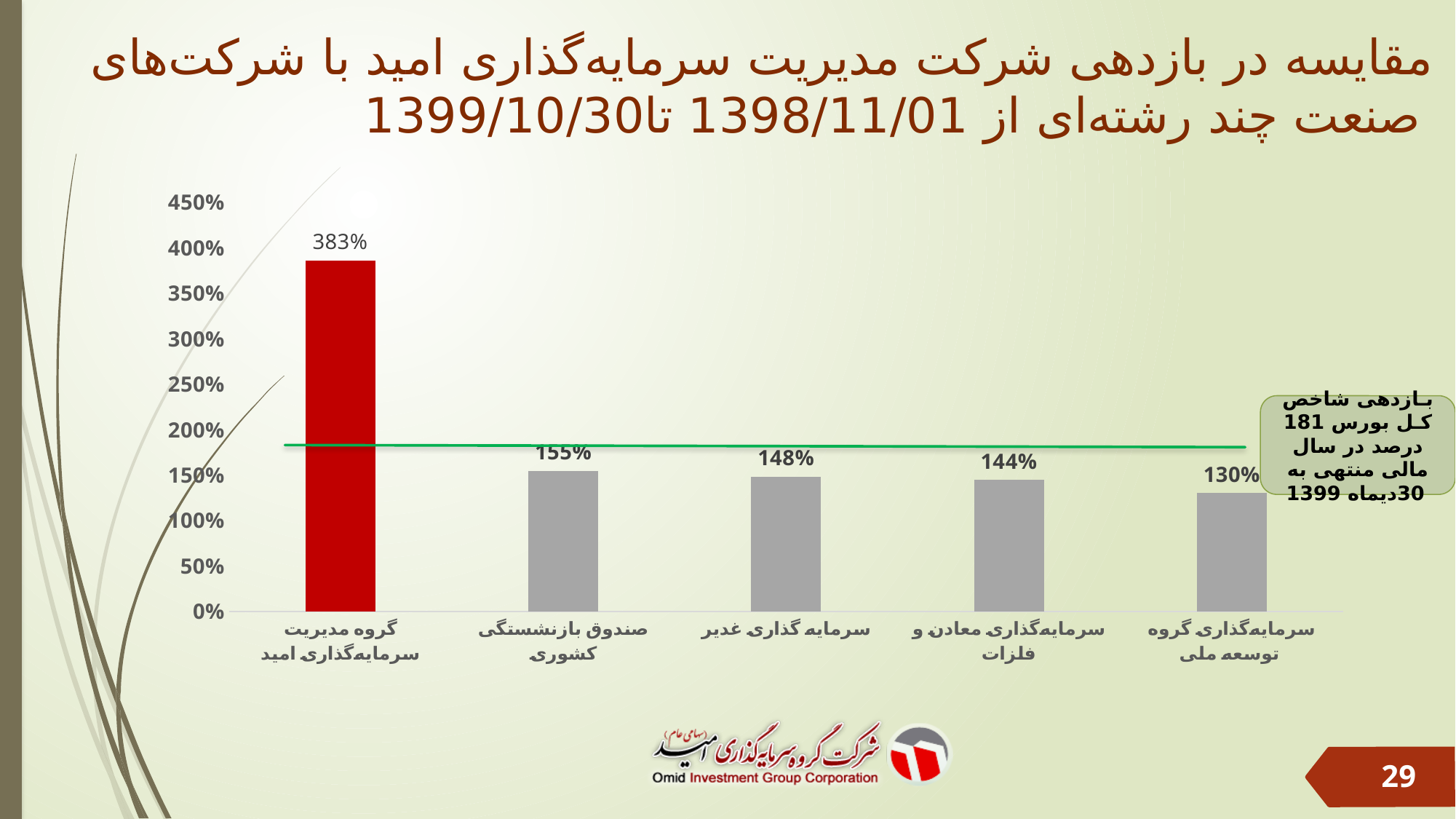
What is the value shown for گروه مدیریت سرمایه‌گذاری امید? 383% What is the value shown for صندوق بازنشستگی کشوری? 155% Which is larger, the value for سرمایه گذاری غدیر or the value for سرمایه‌گذاری گروه توسعه ملی? سرمایه گذاری غدیر What is the value shown for سرمایه‌گذاری معادن و فلزات? 144% What kind of chart is shown on the slide? Bar chart What is the value shown for سرمایه گذاری غدیر? 148% How many categories are shown on the x axis? 5 Which category has the highest value? گروه مدیریت سرمایه‌گذاری امید What is the difference between the values for گروه مدیریت سرمایه‌گذاری امید and صندوق بازنشستگی کشوری? 228% According to the annotation next to the green line, what is the total stock exchange index return (بازدهی شاخص کل بورس) for the fiscal year ending 30 Dey 1399? 181 درصد What is the value shown for سرمایه‌گذاری گروه توسعه ملی? 130% Which category has the lowest value? سرمایه‌گذاری گروه توسعه ملی